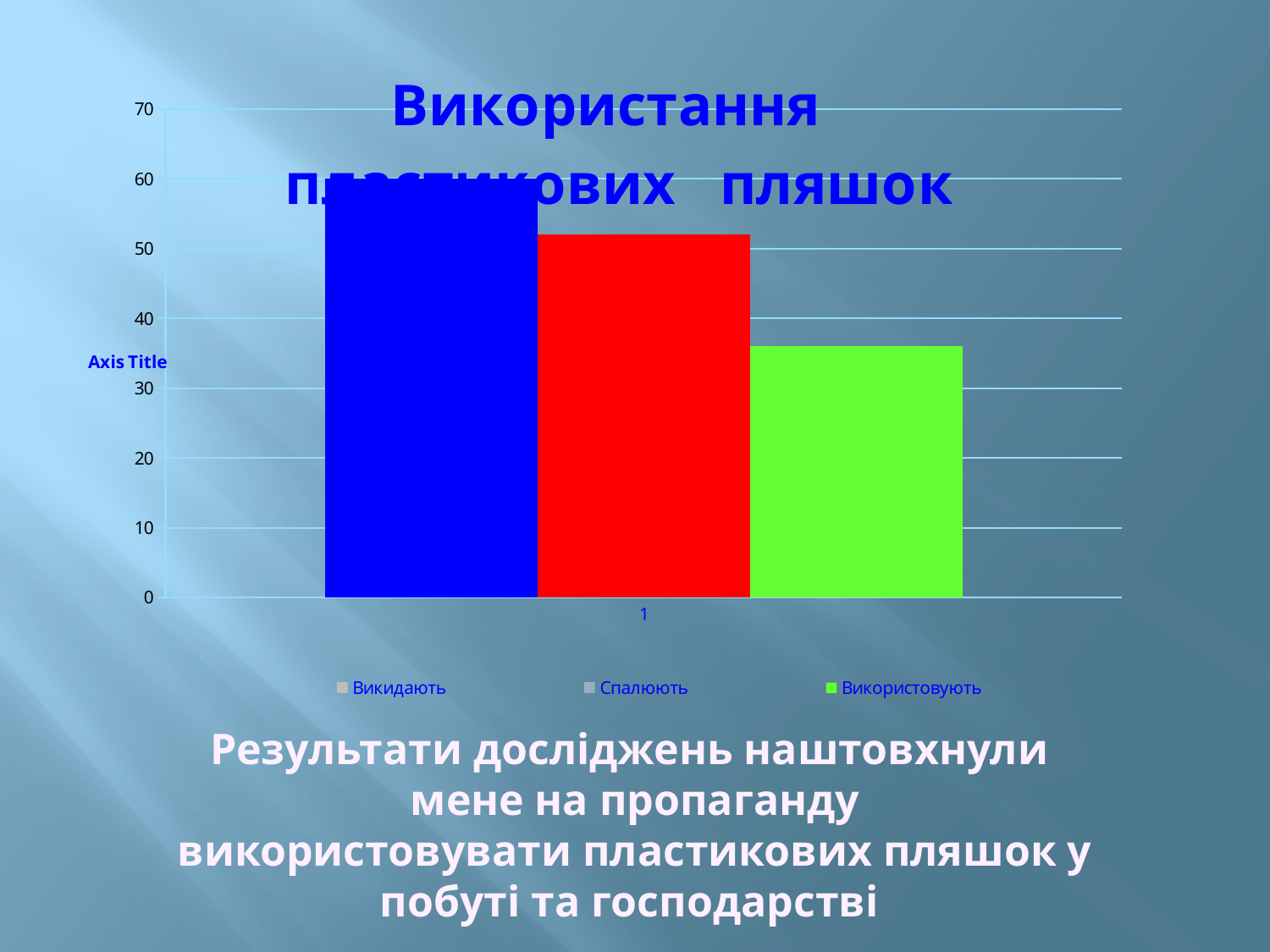
Which is larger, the value for Спалюють or the value for Використовують? Спалюють What is the title of the chart? Використання пластикових пляшок How many series does the legend list? 3 Is the value for Викидають greater or less than 50? greater Which is larger, the value for Викидають or the value for Спалюють? Викидають Is the value for Спалюють greater or less than 40? greater Which series has the lowest bar? Використовують What colour is the bar for Використовують? green Which series has the highest bar? Викидають Is the value for Використовують greater or less than 30? greater What kind of chart is shown on the slide? bar chart